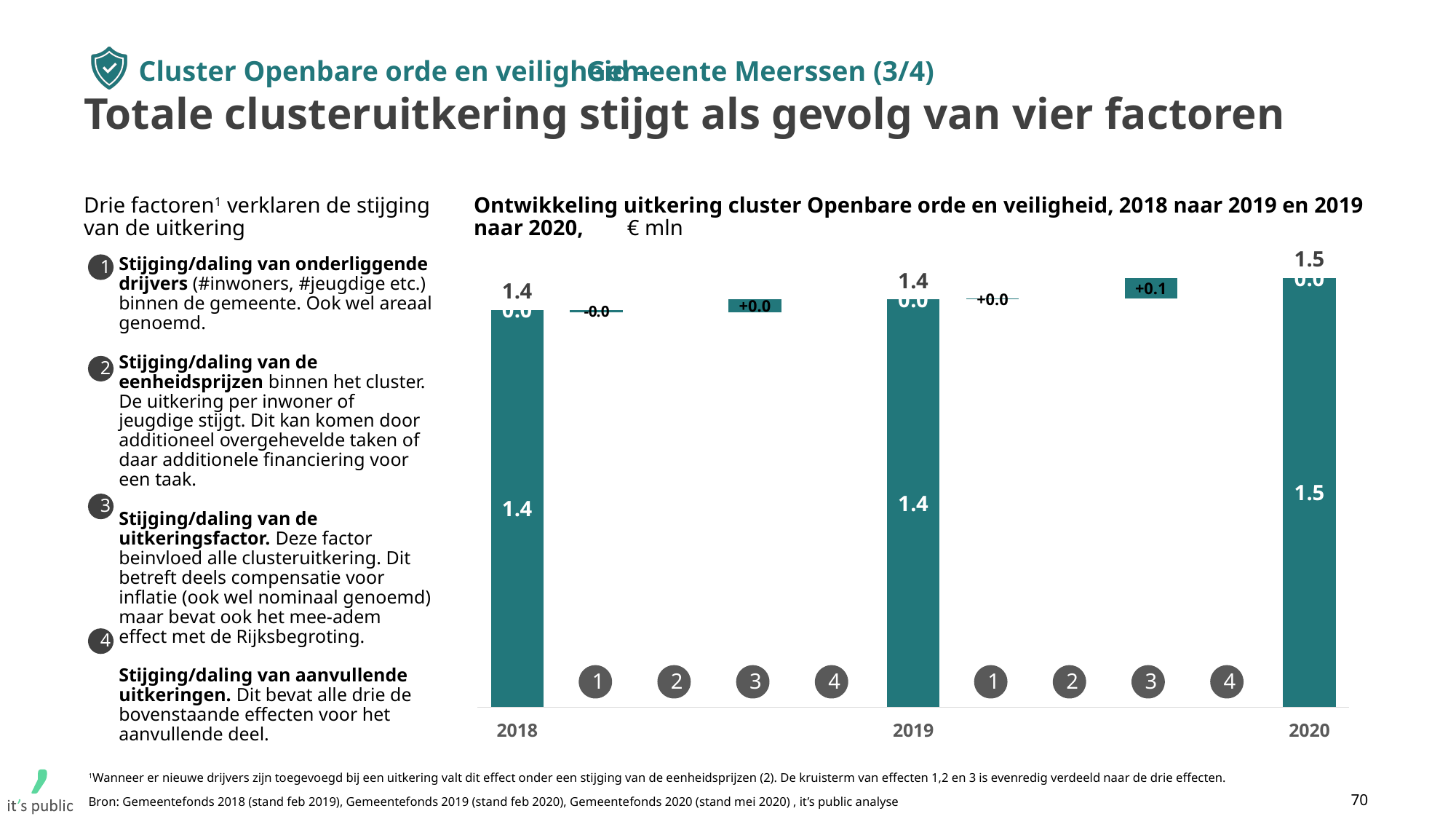
How many year totals are shown in the chart? 3 Is the total for 2020 larger or smaller than the total for 2018? larger Do the year totals rise or fall from 2018 to 2020? rise What is the value of factor 3 (uitkeringsfactor) in the change from 2019 to 2020? +0.1 What is the difference between the 2020 total and the 2018 total? 0.1 What is the total cluster payment shown for 2019? 1.4 What is the total cluster payment shown for 2018? 1.4 Which year has the highest total cluster payment? 2020 In what unit are the values in the chart expressed? € mln What is the value of factor 1 in the change from 2018 to 2019? -0.0 What is the value of factor 3 in the change from 2018 to 2019? +0.0 What is the total cluster payment shown for 2020? 1.5